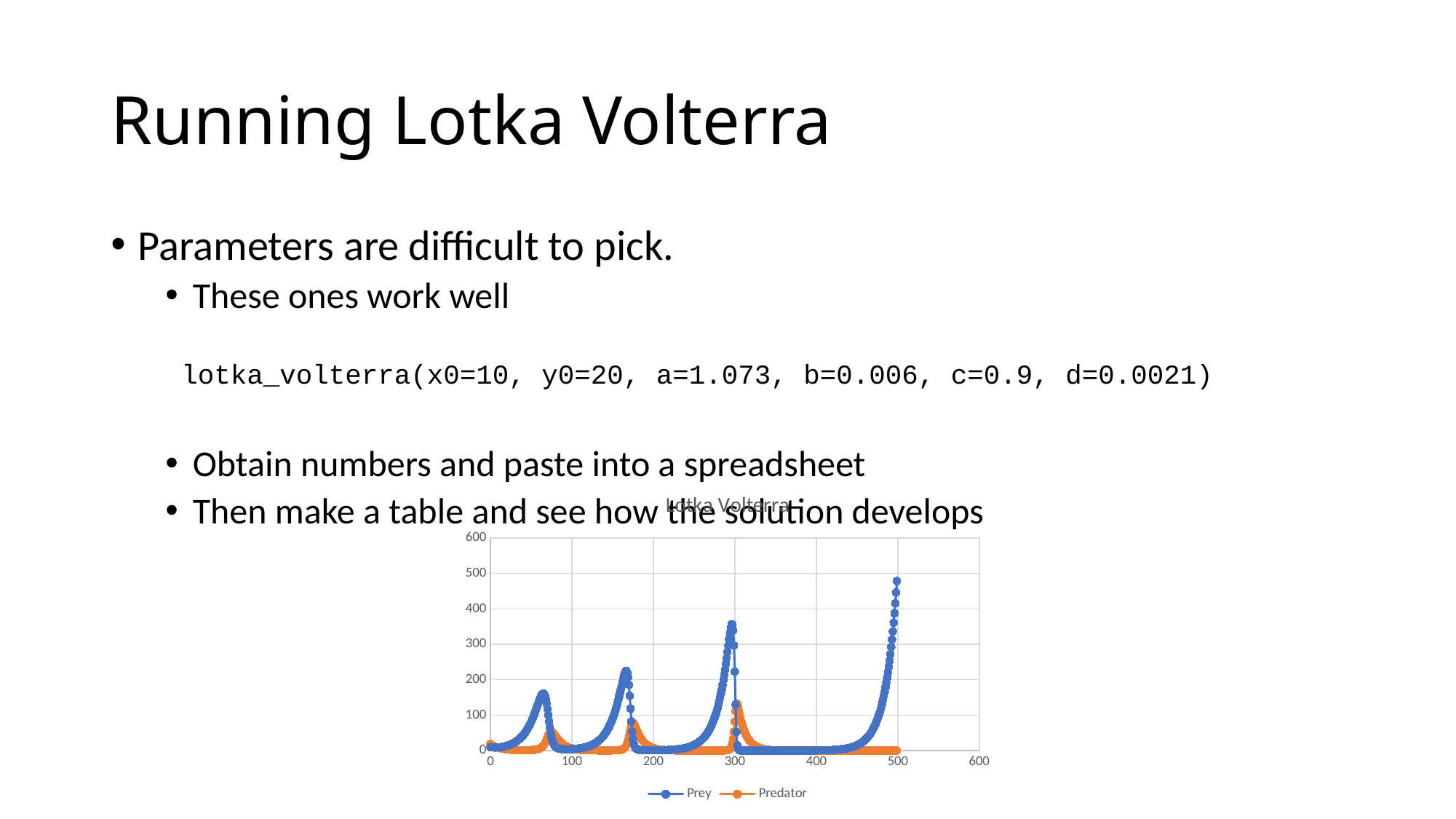
What is the highest value shown on the y axis of the Lotka Volterra chart? 600 Which series reaches the highest value in the Lotka Volterra chart? Prey Is the Prey peak near x = 300 in the Lotka Volterra chart greater or less than 300? greater What is the title of the chart on the slide? Lotka Volterra Do the successive Prey peaks in the Lotka Volterra chart rise or fall as x increases? rise Is the first Prey peak (near x = 70) in the Lotka Volterra chart greater or less than 200? less Is the highest Prey value in the Lotka Volterra chart greater or less than 400? greater What kind of chart is shown on the slide? line chart In the Lotka Volterra chart, which series has the larger peak near x = 300, Prey or Predator? Prey How many series does the legend of the Lotka Volterra chart list? 2 What are the names of the two series in the Lotka Volterra chart's legend? Prey and Predator